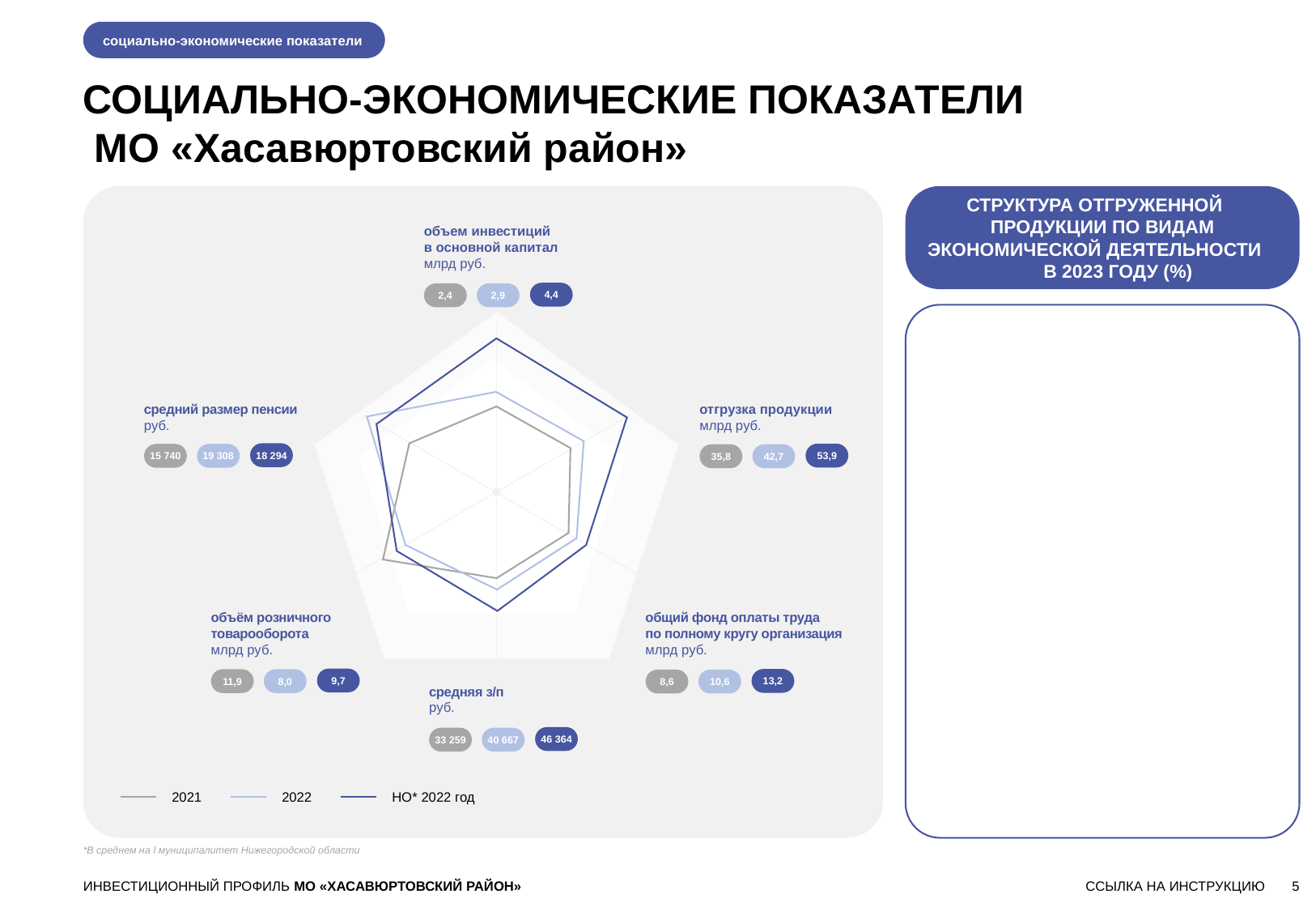
How many indicators (axes) does the radar chart have? 6 What is the value of «средняя з/п» for 2021? 33 259 What is the value of «средний размер пенсии» for 2022? 19 308 What is the value of «объём розничного товарооборота» for 2021? 11,9 Which series has the highest value for «общий фонд оплаты труда по полному кругу организация»? НО* 2022 год Which is larger for «средний размер пенсии»: the 2022 value or the НО* 2022 год value? 2022 What is the difference between the 2022 and 2021 values of «отгрузка продукции»? 6,9 Which series has the lowest value for «объём розничного товарооборота»? 2022 How many series does the legend of the radar chart list? 3 What is the value of «отгрузка продукции» for НО* 2022 год? 53,9 What kind of chart is shown on the left of the slide? radar chart What is the value of «объем инвестиций в основной капитал» for 2022? 2,9